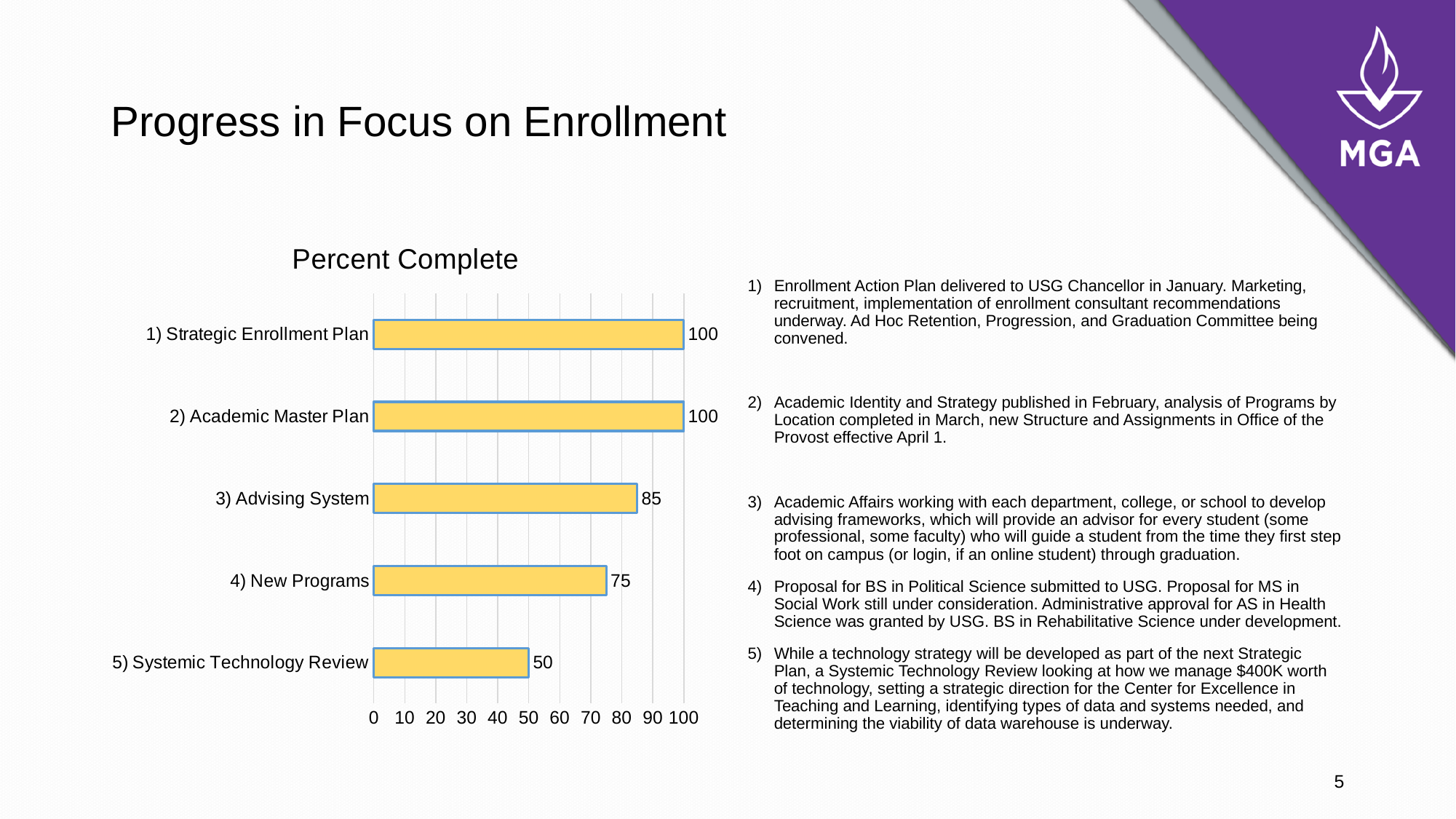
What is the value for 5) Systemic Technology Review? 50 Which is larger, the value for 3) Advising System or the value for 4) New Programs? 3) Advising System Is the value for 4) New Programs greater or less than 60? greater What is the difference between the values for 3) Advising System and 5) Systemic Technology Review? 35 Which category has the lowest value? 5) Systemic Technology Review What is the difference between the values for 1) Strategic Enrollment Plan and 4) New Programs? 25 How many categories are shown in the chart? 5 What is the value for 2) Academic Master Plan? 100 What is the title of the chart? Percent Complete What is the value for 4) New Programs? 75 What kind of chart is shown on the slide? bar chart What is the value for 3) Advising System? 85